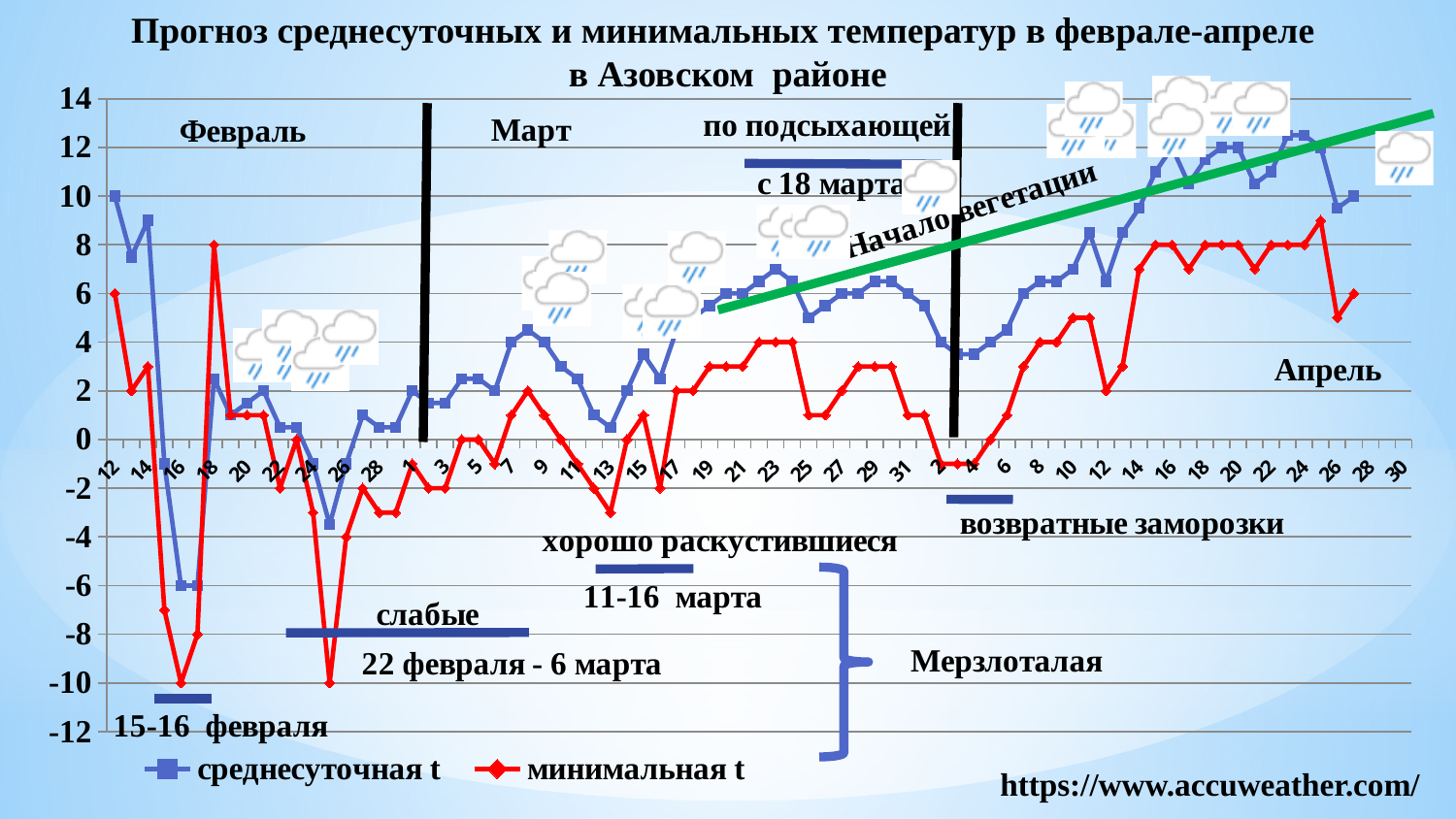
What are the two series named in the legend? среднесуточная t and минимальная t Is the среднесуточная t value on 24 April greater or less than 10? greater Is the среднесуточная t value on 16 February greater or less than -4? less Which colour is used for the минимальная t series? red Is the минимальная t value on 16 February greater or less than -8? less On 12 February, which series has the larger value, среднесуточная t or минимальная t? среднесуточная t In which month does the среднесуточная t series reach its highest value? April (Апрель) How many series does the legend list? 2 What kind of chart is shown on the slide? line chart Do the среднесуточная t values generally rise or fall across April? rise